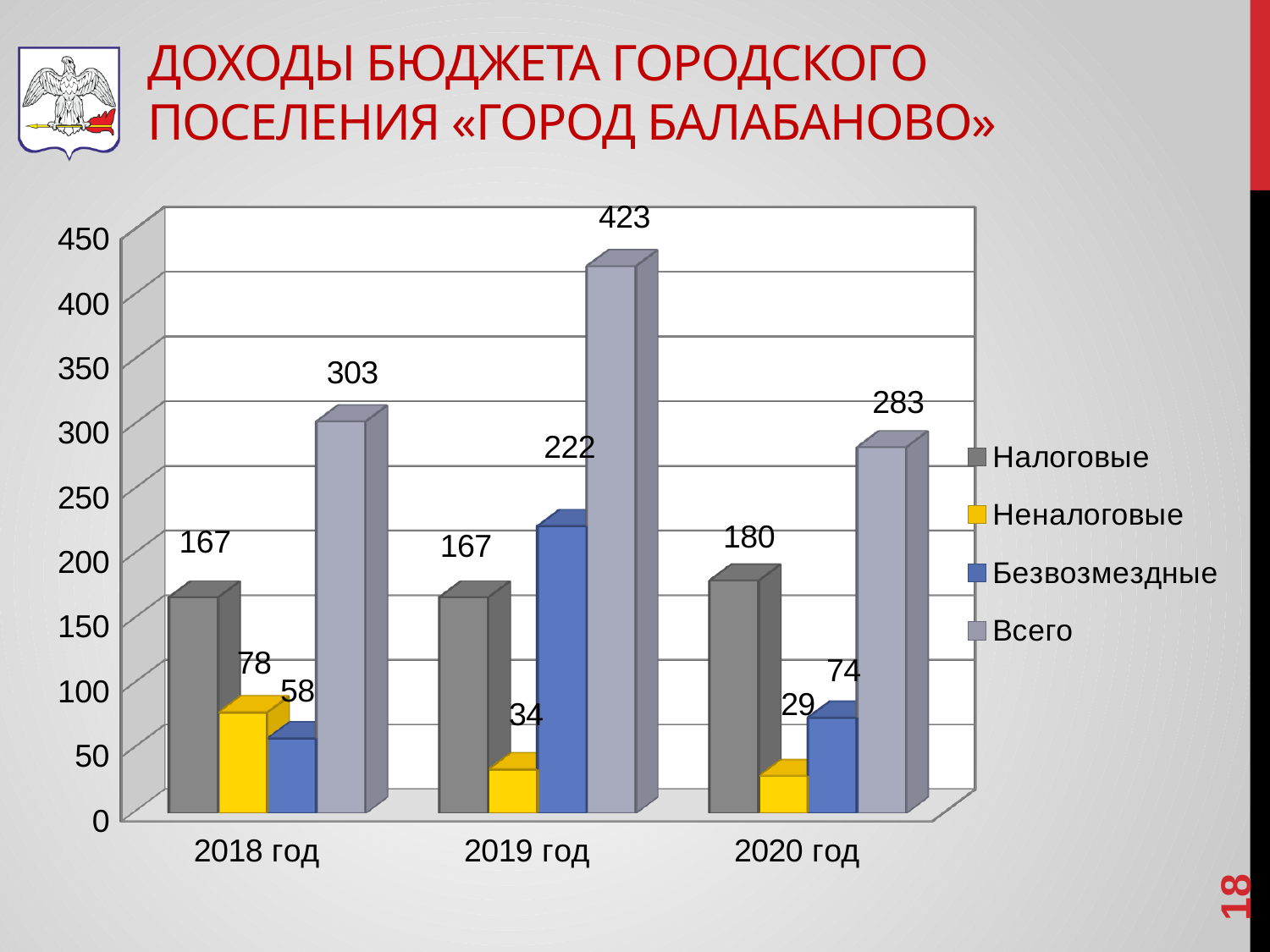
Which is larger: Безвозмездные for 2018 год or Безвозмездные for 2020 год? 2020 год What is the value of Неналоговые for 2020 год? 29 How many years are shown on the x axis? 3 Which series is shown in yellow in the legend? Неналоговые How many series does the legend list? 4 What is the difference between the Всего values for 2019 год and 2020 год? 140 What is the value of Всего for 2018 год? 303 What is the value of Налоговые for 2019 год? 167 In which year is the Всего value highest? 2019 год What kind of chart is shown on the slide? bar chart What is the value of Безвозмездные for 2019 год? 222 In which year is the Неналоговые value lowest? 2020 год